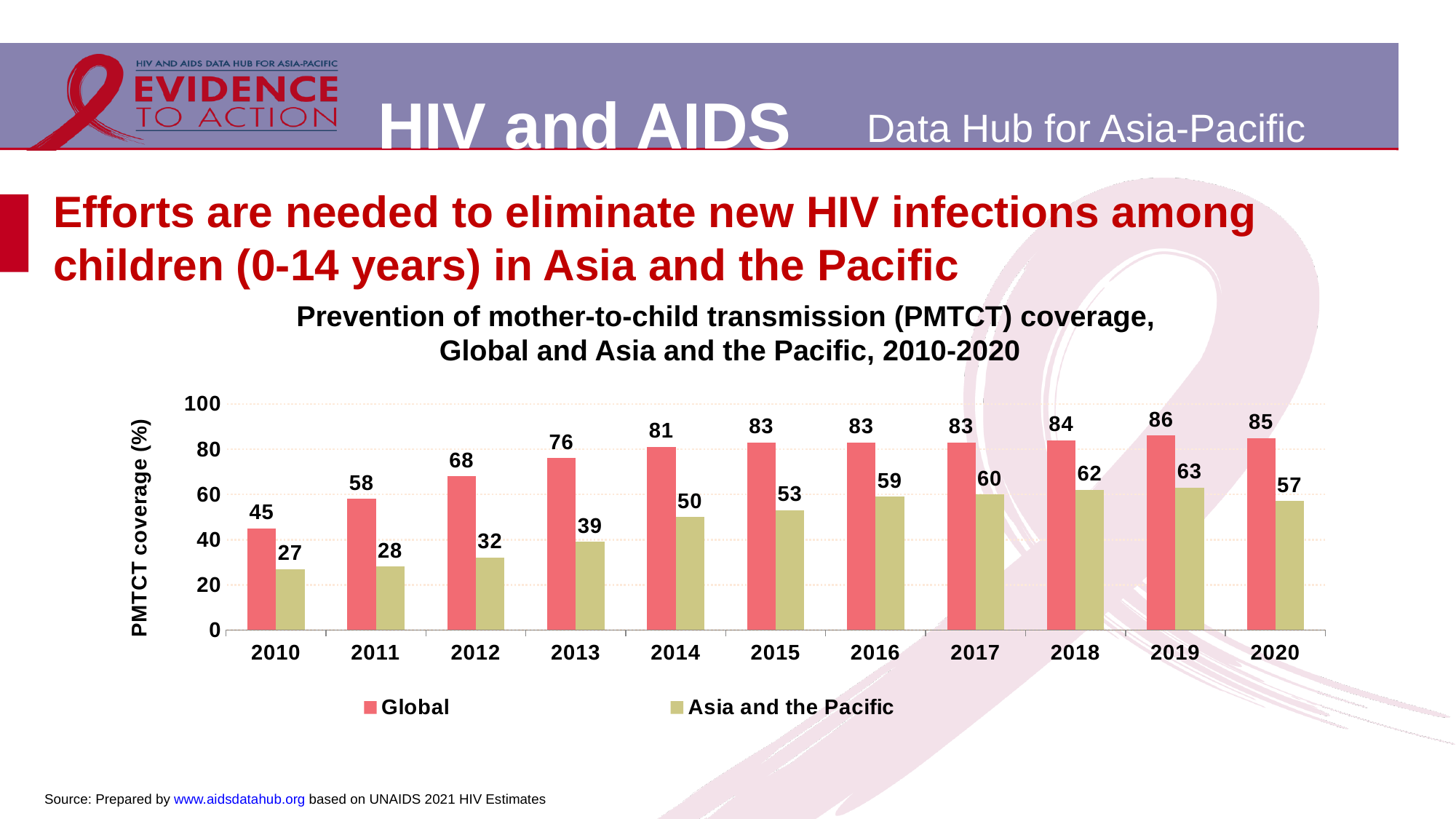
In which year was the Asia and the Pacific PMTCT coverage lowest? 2010 In which year was the Global PMTCT coverage highest? 2019 What is the label of the y axis of the chart? PMTCT coverage (%) Did the Asia and the Pacific PMTCT coverage rise or fall from 2010 to 2019? Rise By how much did the Asia and the Pacific PMTCT coverage change from 2019 to 2020? Fell by 6 What was the PMTCT coverage for Asia and the Pacific in 2018? 62 What type of chart is used to show PMTCT coverage? Bar chart How many series does the chart legend list? 2 What was the Global PMTCT coverage in 2013? 76 What is the difference between the Global and Asia and the Pacific PMTCT coverage in 2020? 28 How many years are shown on the x axis of the chart? 11 Which series had the higher PMTCT coverage in 2015, Global or Asia and the Pacific? Global